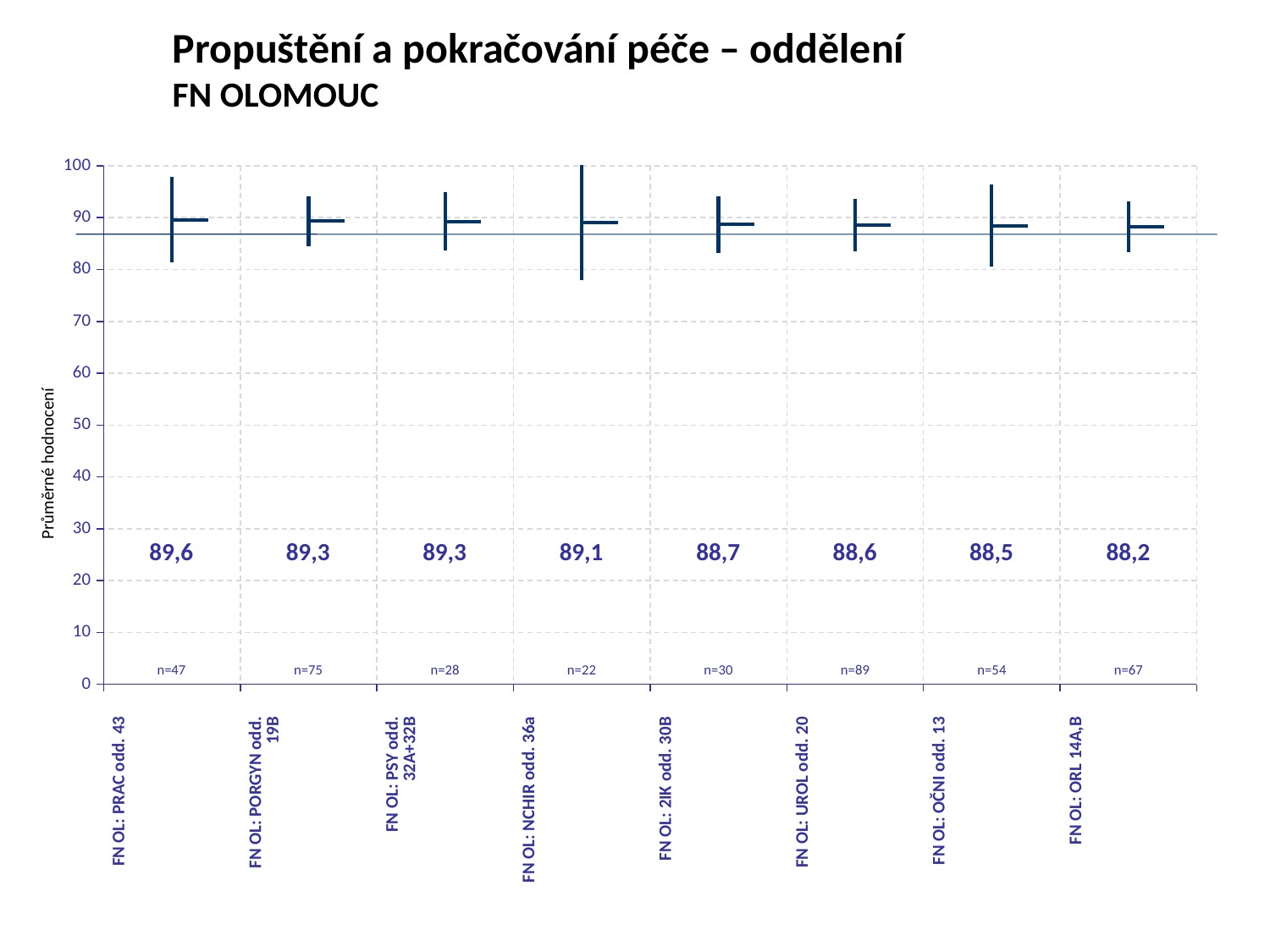
What is the average rating for FN OL: ORL 14A,B? 88,2 Which has a higher average rating, FN OL: 2IK odd. 30B or FN OL: OČNI odd. 13? FN OL: 2IK odd. 30B What is the average rating for FN OL: NCHIR odd. 36a? 89,1 Which department has the lowest average rating? FN OL: ORL 14A,B What is the difference between the average rating of FN OL: PRAC odd. 43 and FN OL: ORL 14A,B? 1,4 Is the average rating for FN OL: PORGYN odd. 19B greater or less than 80? greater Which department has the highest average rating? FN OL: PRAC odd. 43 Do the average ratings rise or fall from left to right along the x axis? fall What is the average rating for FN OL: PRAC odd. 43? 89,6 How many departments are shown on the chart? 8 What is the sample size (n) shown for FN OL: UROL odd. 20? n=89 What is the label of the vertical axis? Průměrné hodnocení